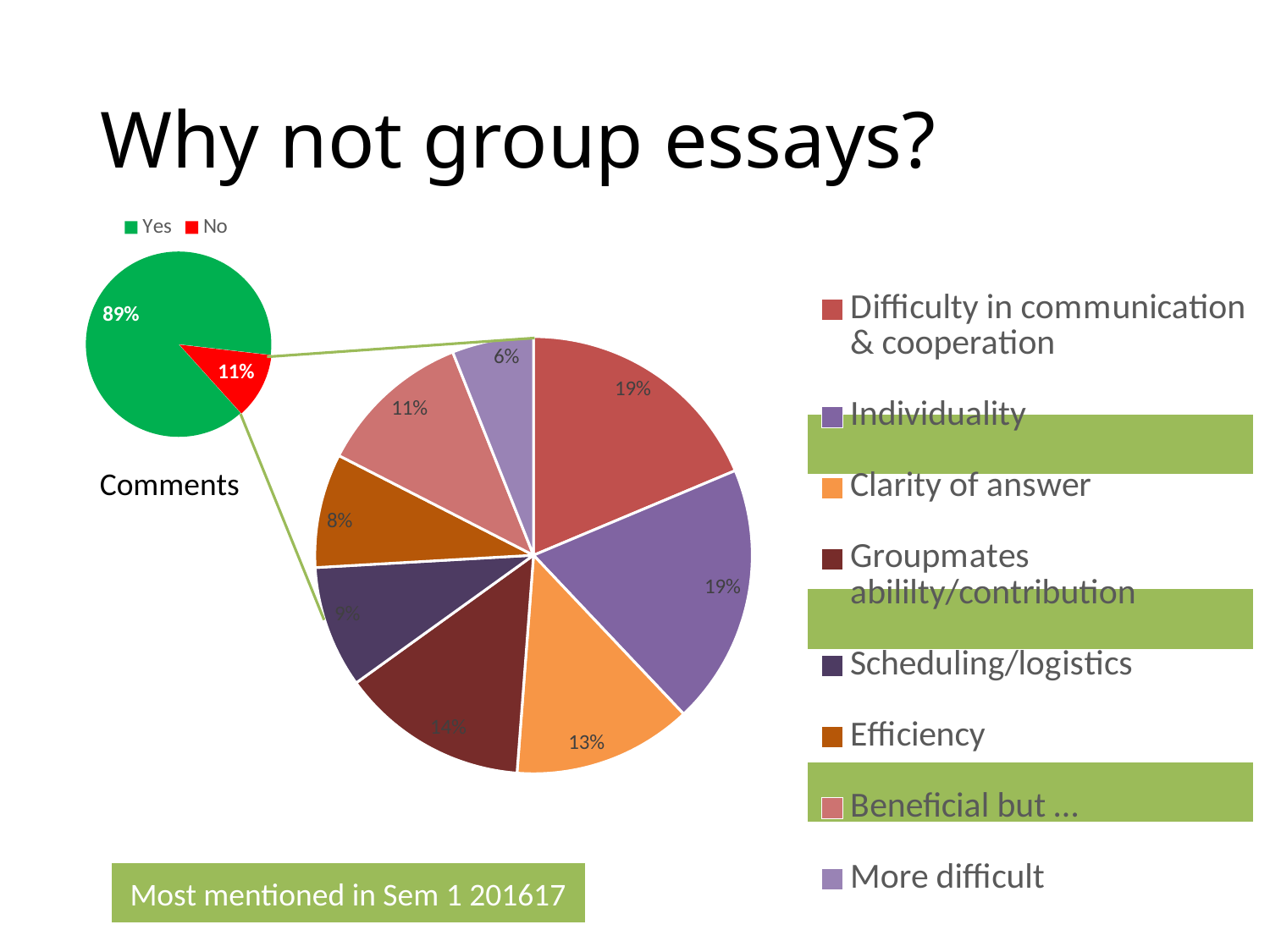
In the large Comments pie chart, what percentage is shown for Clarity of answer? 13% In the large Comments pie chart, what is the difference in percentage points between Difficulty in communication & cooperation and Clarity of answer? 6 percentage points In the large Comments pie chart, which category has the smallest slice? More difficult In the small Yes/No pie chart at the top left, which slice is larger, Yes or No? Yes How many entries does the legend of the small Yes/No chart list? 2 In the large Comments pie chart, what percentage is shown for Difficulty in communication & cooperation? 19% In the small Yes/No pie chart at the top left, what percentage is shown for Yes? 89% What kind of chart is the large Comments chart in the middle of the slide? Pie chart In the small Yes/No pie chart at the top left, what percentage is shown for No? 11% In the large Comments pie chart, what percentage is shown for Efficiency? 8% In the large Comments pie chart, what percentage is shown for More difficult? 6% How many categories does the legend of the large Comments pie chart list? 8